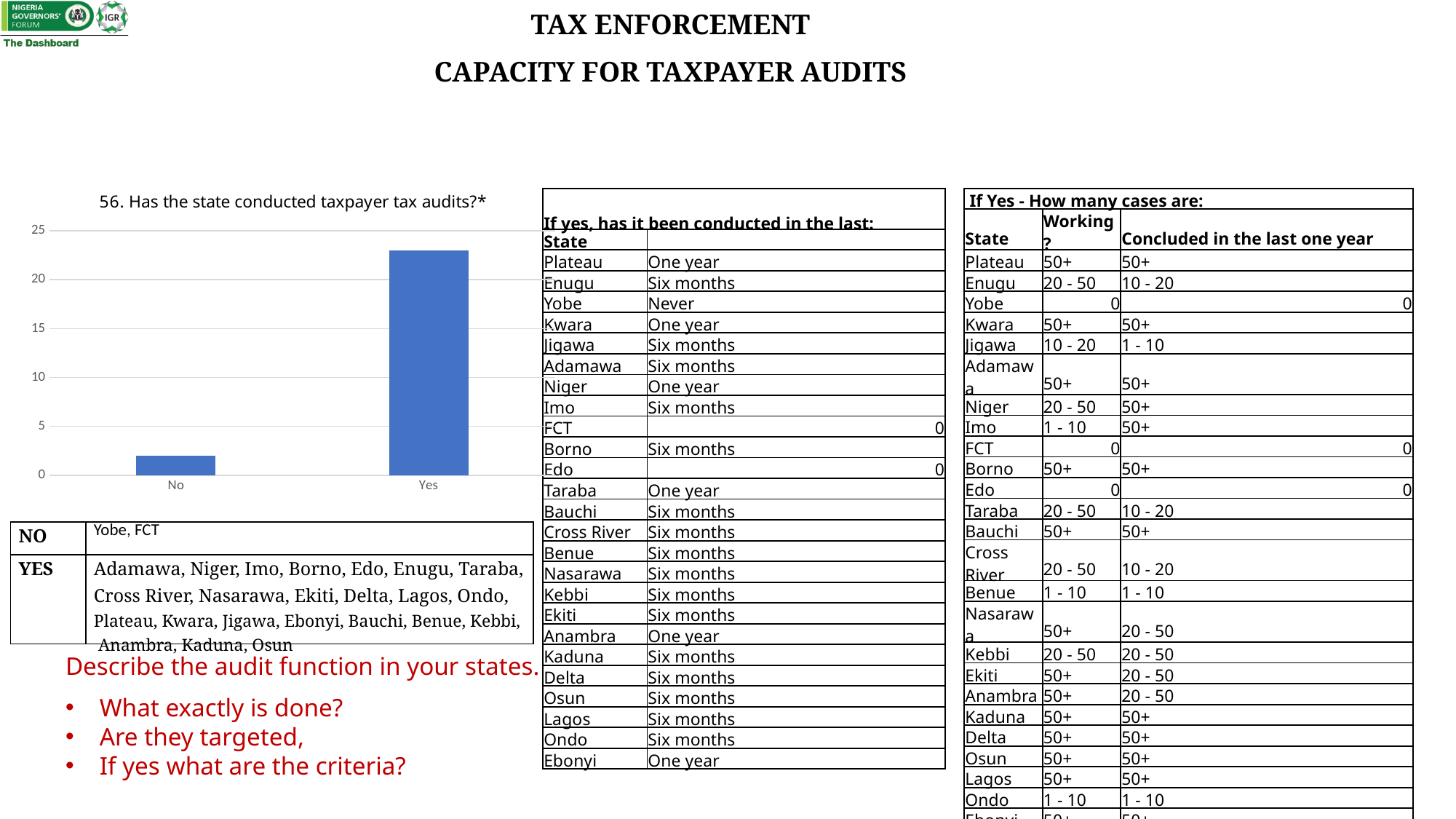
What is the highest tick value shown on the y axis of the chart "Has the state conducted taxpayer tax audits?"? 25 Which category has the lowest bar in the chart "Has the state conducted taxpayer tax audits?"? No What is the title of the bar chart on the slide? 56. Has the state conducted taxpayer tax audits?* Which category has the highest bar in the chart "Has the state conducted taxpayer tax audits?"? Yes What kind of chart is used for question 56, "Has the state conducted taxpayer tax audits?"? Bar chart In the chart "Has the state conducted taxpayer tax audits?", which is larger, the value for No or the value for Yes? Yes In the chart "Has the state conducted taxpayer tax audits?", is the value for Yes greater or less than 25? less In the chart "Has the state conducted taxpayer tax audits?", is the value for No greater or less than 5? less In the chart "Has the state conducted taxpayer tax audits?", is the value for Yes greater or less than 20? greater How many categories are shown on the x axis of the chart "Has the state conducted taxpayer tax audits?"? 2